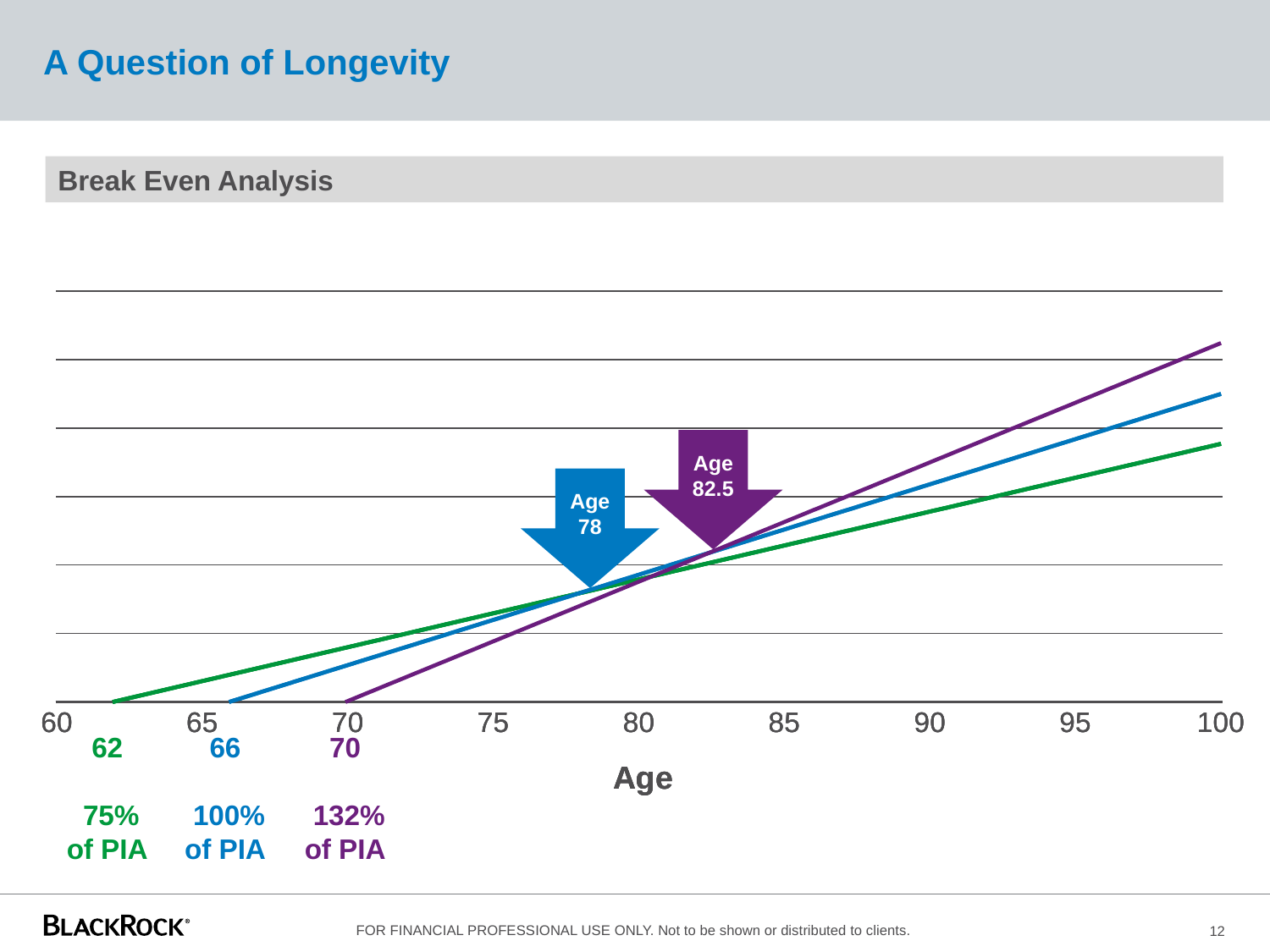
At what age is the first break-even point marked by the blue arrow? Age 78 At what age does the purple line (132% of PIA) start? 70 At what age is the second break-even point marked by the purple arrow? Age 82.5 At what age does the green line (75% of PIA) start? 62 What kind of chart is shown on the slide? line chart How many lines are plotted on the chart? 3 What is the title of the chart section? Break Even Analysis Which line is lowest at age 100? 75% of PIA (green) At what age does the blue line (100% of PIA) start? 66 Do the lines rise or fall as age increases along the x axis? rise Which line is highest at age 100? 132% of PIA (purple) What is the label of the x axis? Age